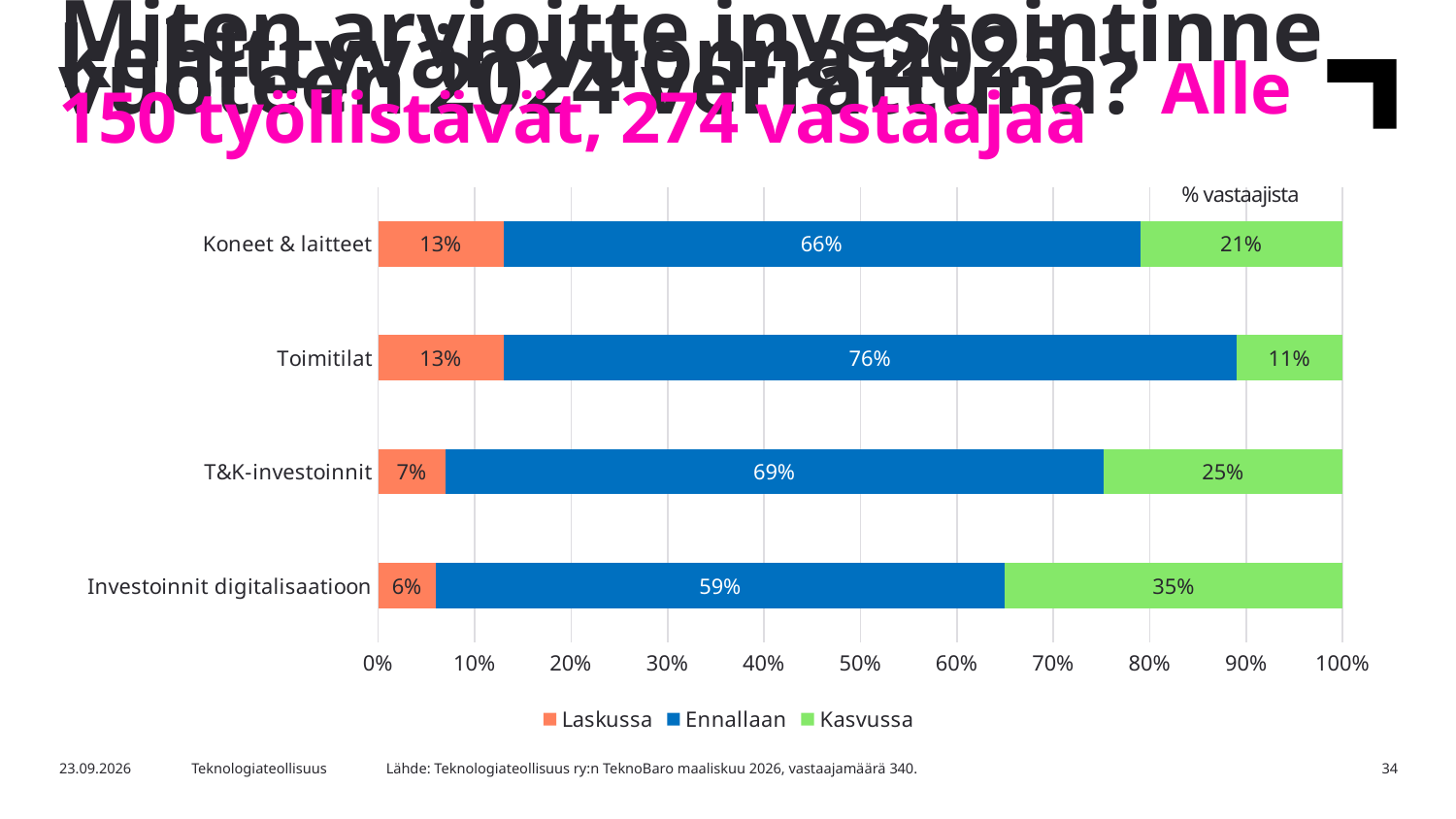
Which category has the highest Kasvussa value? Investoinnit digitalisaatioon Which series is shown in green in the legend? Kasvussa What is the difference between the Kasvussa values for T&K-investoinnit and Toimitilat? 14% What is the Ennallaan value for Toimitilat? 76% What kind of chart is shown on the slide? Stacked bar chart What is the total of the stacked bar for Koneet & laitteet? 100% Which is larger, the Ennallaan value for Koneet & laitteet or for T&K-investoinnit? T&K-investoinnit How many categories are shown on the chart? 4 Which category has the lowest Ennallaan value? Investoinnit digitalisaatioon What is the Laskussa value for T&K-investoinnit? 7% What is the Kasvussa value for Investoinnit digitalisaatioon? 35% How many series does the legend list? 3